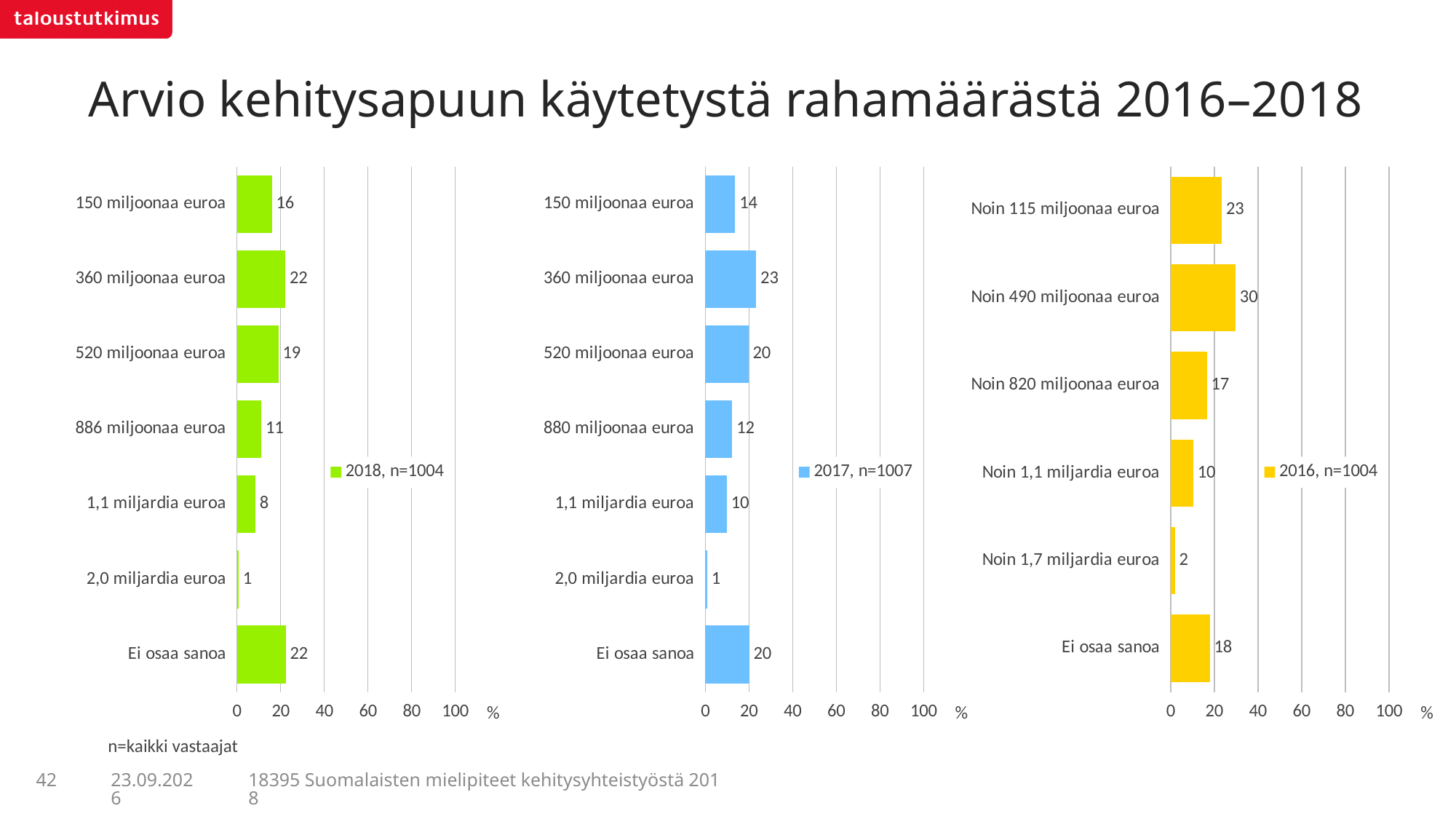
In the 2016 chart (right), which category has the highest value? Noin 490 miljoonaa euroa In the 2018 chart (left), which is larger: 150 miljoonaa euroa or 886 miljoonaa euroa? 150 miljoonaa euroa In the 2017 chart (middle), is the value for Ei osaa sanoa greater or less than 40? less In the 2016 chart (right), what is the difference between Noin 490 miljoonaa euroa and Noin 115 miljoonaa euroa? 7 How many categories are shown in the 2016 chart (right)? 6 What is the legend entry of the middle chart? 2017, n=1007 In the 2018 chart (left), what percentage chose 360 miljoonaa euroa? 22 In the 2016 chart (right), what percentage chose Noin 820 miljoonaa euroa? 17 In the 2017 chart (middle), which category has the highest value? 360 miljoonaa euroa In the 2017 chart (middle), what percentage chose 520 miljoonaa euroa? 20 What type of chart is the 2018 chart (left)? bar chart In the 2018 chart (left), which category has the lowest value? 2,0 miljardia euroa